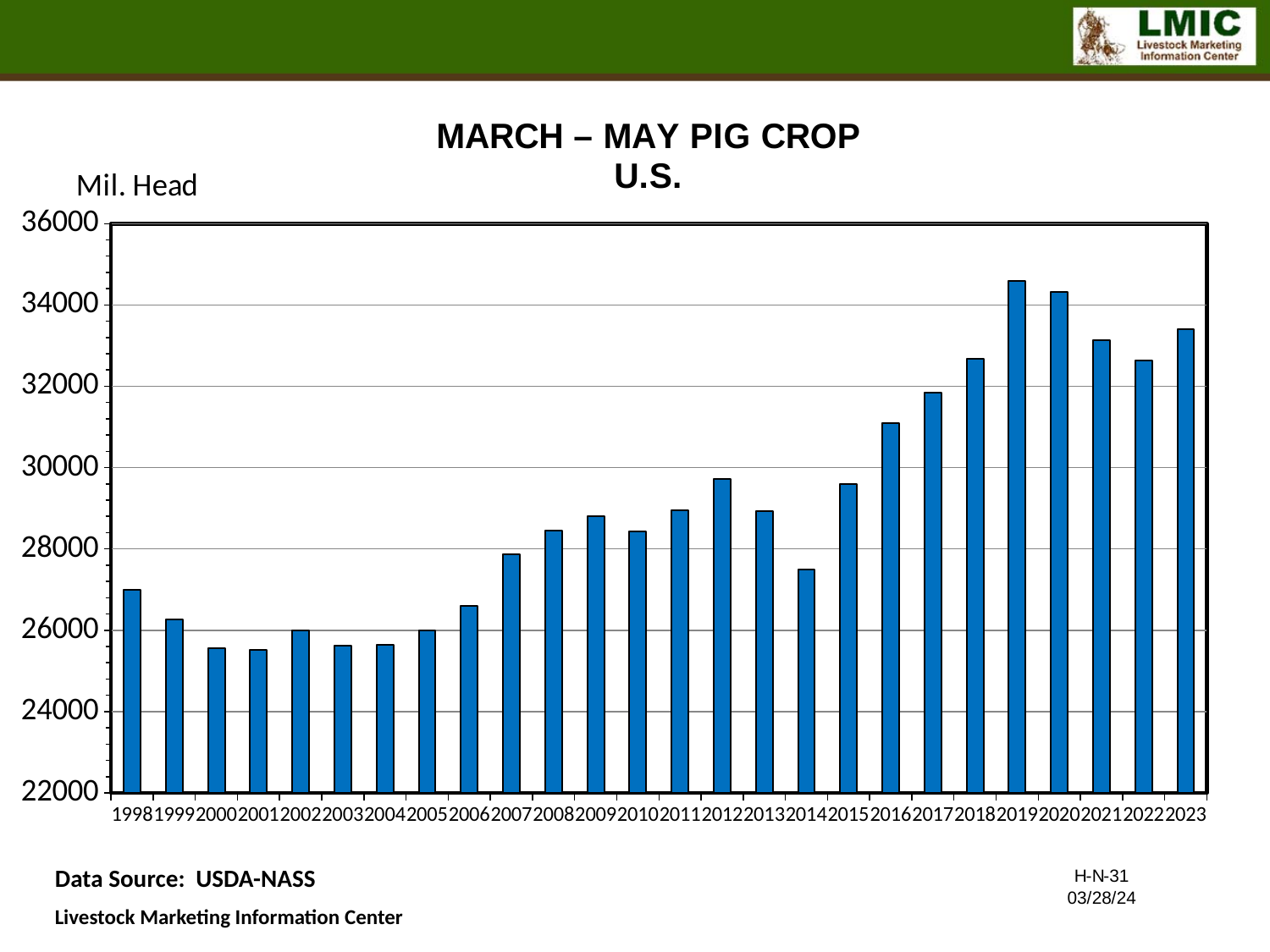
Which year has the larger pig crop, 2021 or 2022? 2021 How many years (bars) are plotted on the chart? 26 Is the value for 2023 greater or less than 32000? greater Which year has the larger pig crop, 2019 or 2023? 2019 What kind of chart is shown on the slide? bar chart Which year has the highest March–May pig crop? 2019 Do the values rise or fall from 2014 to 2019? rise Is the value for 2003 greater or less than 26000? less Is the value for 2014 greater or less than 28000? less What unit is shown on the vertical axis label? Mil. Head